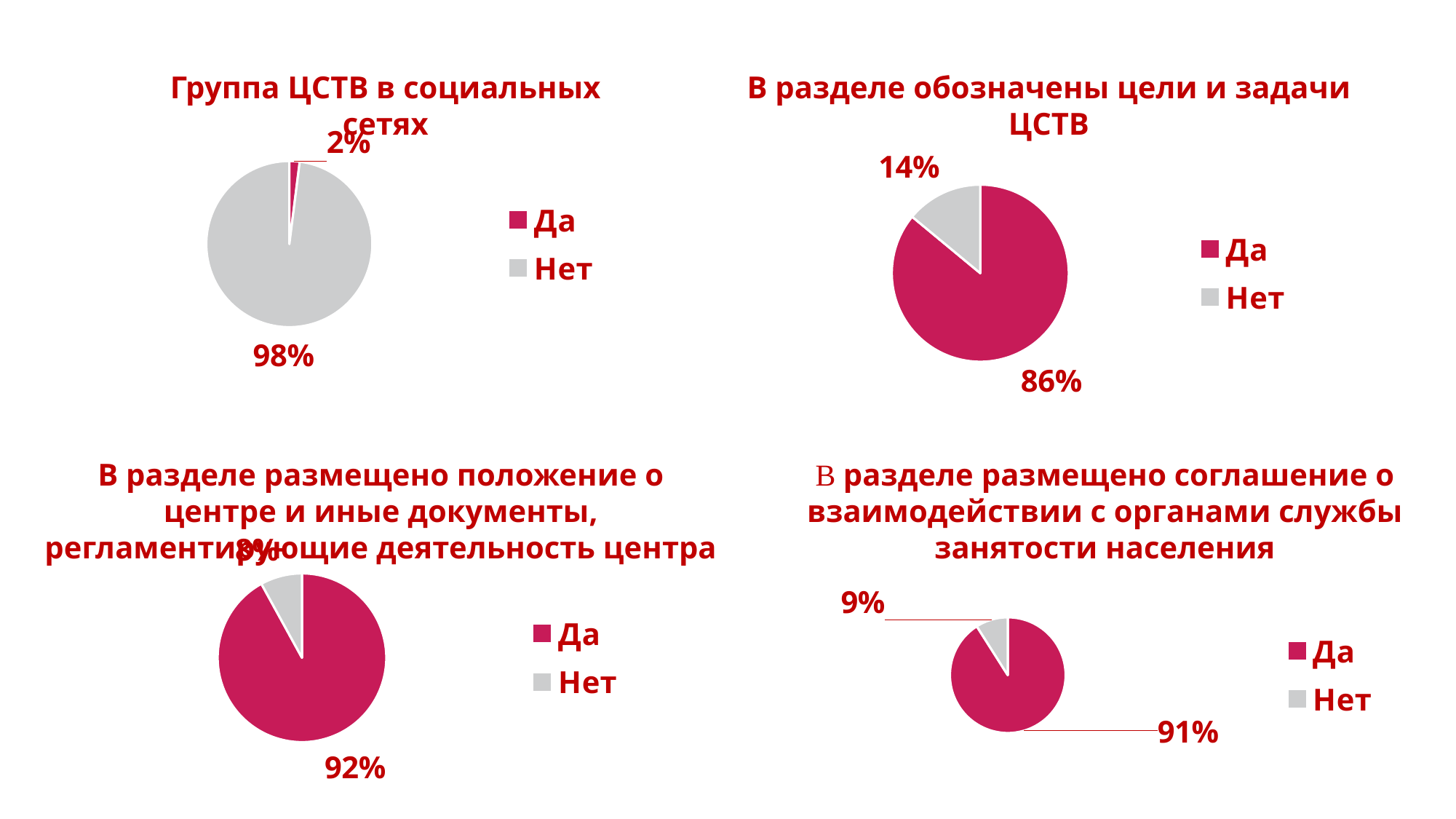
In the chart titled "В разделе обозначены цели и задачи ЦСТВ", which category has the smallest slice? Нет In the chart titled "В разделе обозначены цели и задачи ЦСТВ", what share is labelled for "Нет"? 14% In the bottom-left chart ("В разделе размещено положение о центре..."), what share is labelled for "Да"? 92% In the chart titled "В разделе обозначены цели и задачи ЦСТВ", what is the difference between the "Да" and "Нет" shares? 72% In the chart titled "Группа ЦСТВ в социальных сетях", what share is labelled for the "Да" slice? 2% What type of chart is used in the top-left chart titled "Группа ЦСТВ в социальных сетях"? Pie chart In the bottom-right chart ("В разделе размещено соглашение о взаимодействии..."), what share is labelled for "Нет"? 9% In the chart titled "Группа ЦСТВ в социальных сетях", what share is labelled for the "Нет" slice? 98% How many entries does the legend of the chart titled "В разделе обозначены цели и задачи ЦСТВ" list? 2 In the bottom-right chart ("В разделе размещено соглашение о взаимодействии..."), what share is labelled for "Да"? 91% In the chart titled "Группа ЦСТВ в социальных сетях", which category has the largest slice? Нет In the chart titled "В разделе обозначены цели и задачи ЦСТВ", what share is labelled for "Да"? 86%